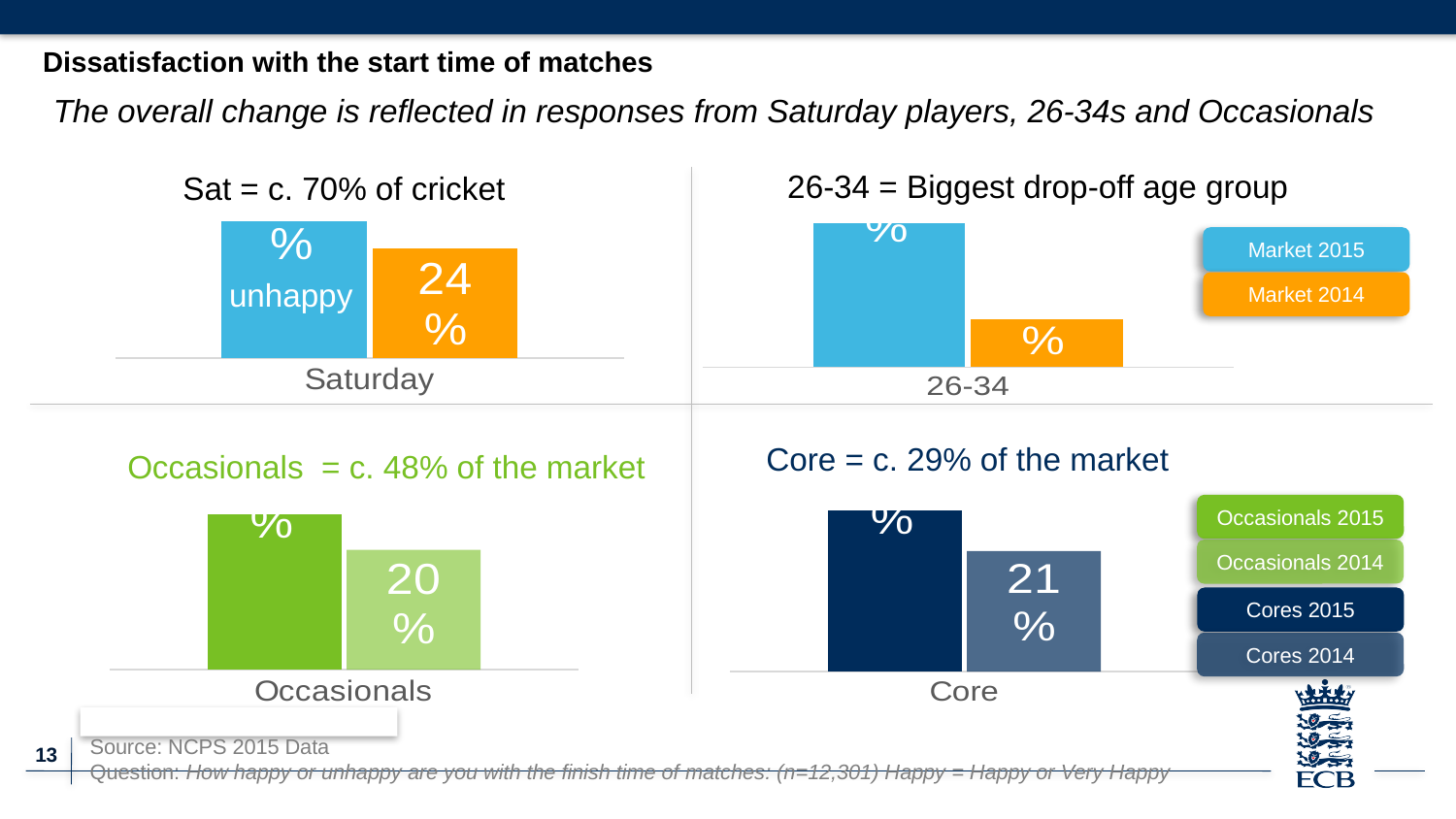
How many series does the legend next to the '26-34 = Biggest drop-off age group' chart list? 2 In the 'Core = c. 29% of the market' chart, which bar is taller, Cores 2015 or Cores 2014? Cores 2015 In the 'Sat = c. 70% of cricket' chart, what is the value of the orange (Market 2014) bar for Saturday? 24% What kind of chart is the 'Sat = c. 70% of cricket' chart? Bar chart In the 'Occasionals = c. 48% of the market' chart, which bar is taller, Occasionals 2015 or Occasionals 2014? Occasionals 2015 What are the two legend entries shown next to the '26-34 = Biggest drop-off age group' chart? Market 2015 and Market 2014 In the 'Sat = c. 70% of cricket' chart, which bar is taller, Market 2015 or Market 2014? Market 2015 In the 'Core = c. 29% of the market' chart, what is the value of the lighter blue (Cores 2014) bar? 21% In the 'Occasionals = c. 48% of the market' chart, what is the value of the light green (Occasionals 2014) bar? 20% How many entries does the legend next to the 'Core = c. 29% of the market' chart list? 4 How many categories are shown on the x axis of the 'Occasionals = c. 48% of the market' chart? 1